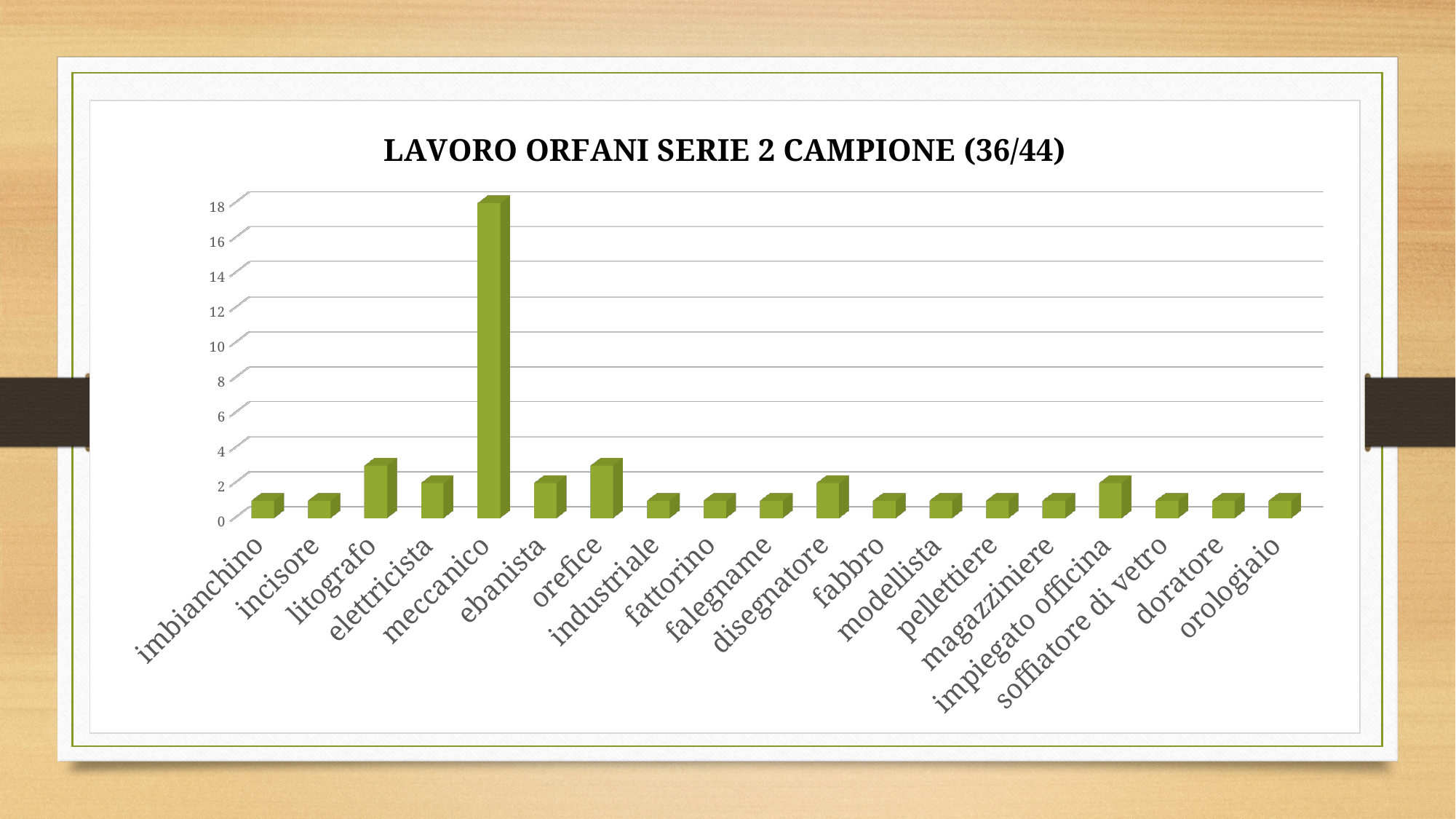
Which has a larger value, meccanico or litografo? meccanico Is the value for litografo greater or less than 4? less Is the value for imbianchino greater or less than 2? less What kind of chart is shown on the slide? bar chart Is the value for meccanico greater or less than 16? greater Which category has the highest value in the chart? meccanico How many categories are shown on the x axis of the chart? 19 What is the highest value shown on the vertical axis of the chart? 18 What is the title of the chart? LAVORO ORFANI SERIE 2 CAMPIONE (36/44) Which has a larger value, orefice or fattorino? orefice Which has a larger value, litografo or incisore? litografo